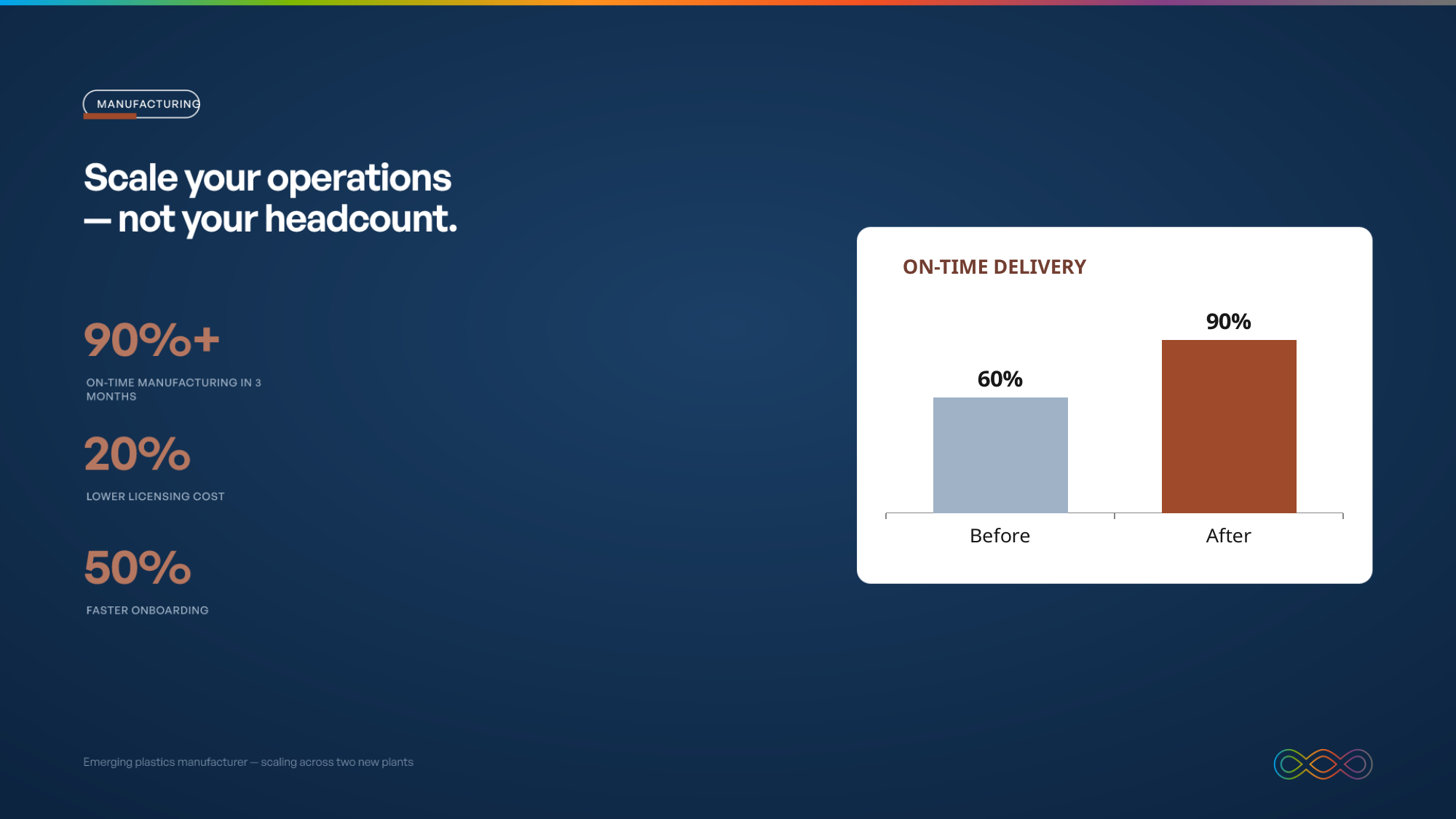
Do the values rise or fall from Before to After? rise What is the on-time delivery value for Before? 60% What colour is the After bar? brown What kind of chart is shown on the slide? bar chart What is the title of the chart? ON-TIME DELIVERY What is the difference between the After and Before on-time delivery values? 30% Is the on-time delivery value for After larger or smaller than the value for Before? larger Which category has the lower on-time delivery value? Before How many categories are shown in the chart? 2 What is the on-time delivery value for After? 90% Which category has the higher on-time delivery value? After